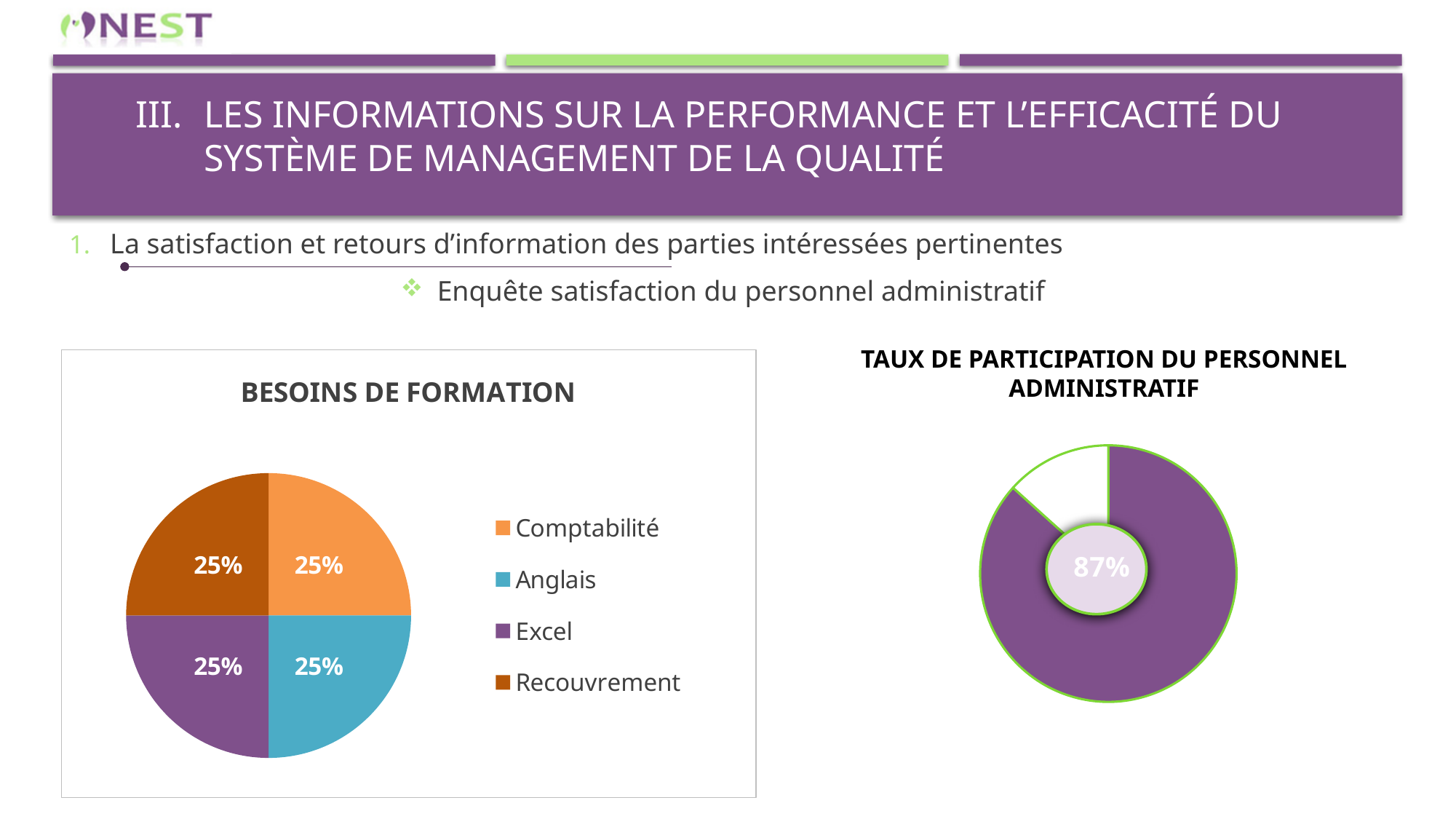
In the 'BESOINS DE FORMATION' chart, what is the difference between the shares for Excel and Anglais? 0% In the 'BESOINS DE FORMATION' chart, what share is shown for Recouvrement? 25% What kind of chart is the 'BESOINS DE FORMATION' chart? pie chart In the 'TAUX DE PARTICIPATION DU PERSONNEL ADMINISTRATIF' chart, what participation rate is displayed? 87% In the 'BESOINS DE FORMATION' chart, which category is shown in orange in the legend? Comptabilité In the 'BESOINS DE FORMATION' chart, what share is shown for Comptabilité? 25% In the 'BESOINS DE FORMATION' chart, what share is shown for Anglais? 25% In the 'BESOINS DE FORMATION' chart, how many categories does the pie contain? 4 In the 'BESOINS DE FORMATION' chart, which category is shown in blue in the legend? Anglais What kind of chart is the 'TAUX DE PARTICIPATION DU PERSONNEL ADMINISTRATIF' chart? doughnut chart In the 'BESOINS DE FORMATION' chart, what is the combined share of Comptabilité and Recouvrement? 50% In the 'BESOINS DE FORMATION' chart, what share is shown for Excel? 25%